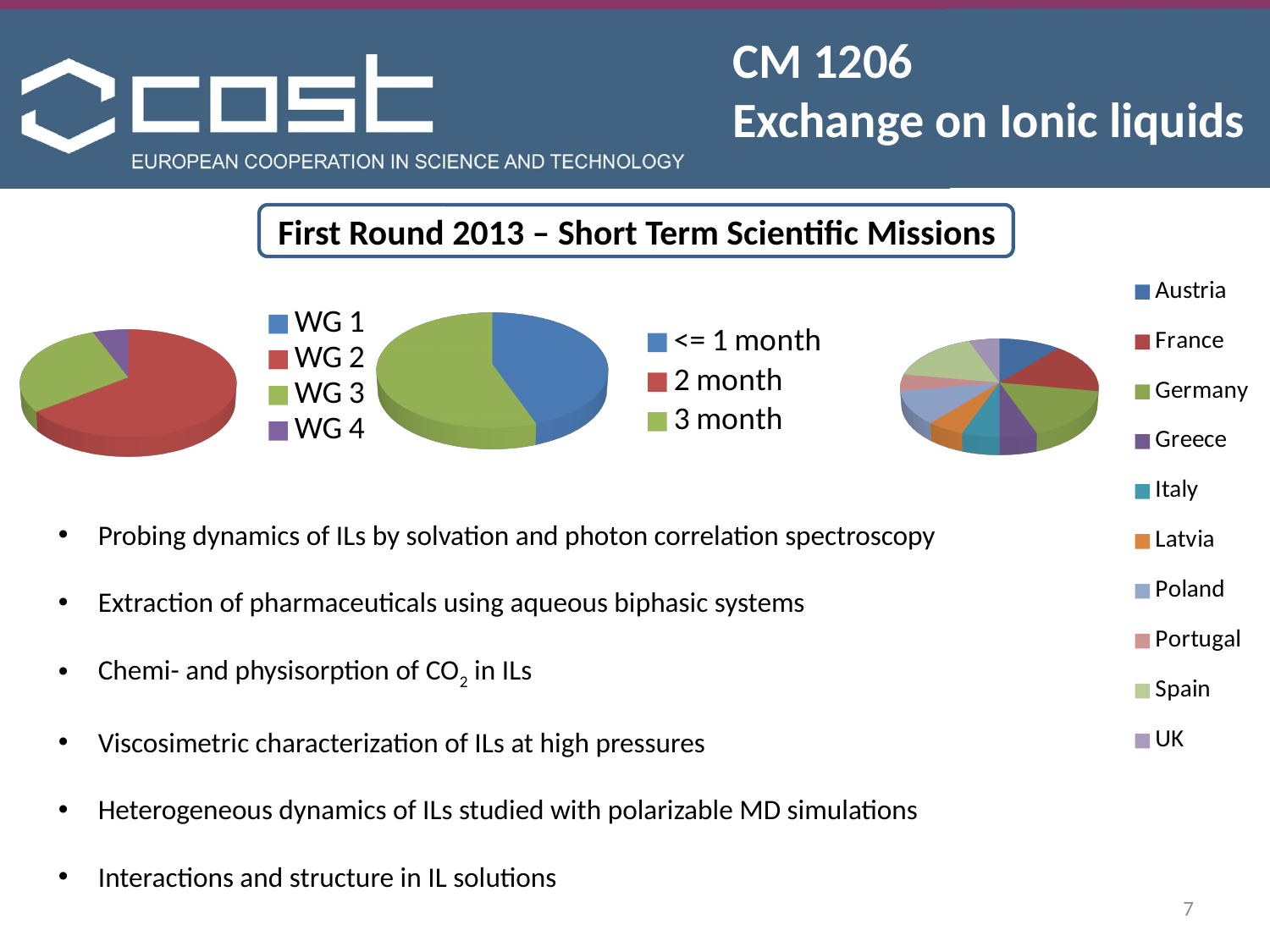
What kind of chart is the rightmost chart on the slide (the one with the country legend)? pie chart In the leftmost pie chart, how many working groups does the legend list? 4 In the middle pie chart, which category has the largest slice? 3 month In the leftmost pie chart, what colour represents WG 2? red In the middle pie chart, which slice is larger, '<= 1 month' or '3 month'? 3 month In the leftmost pie chart, which slice is larger, WG 3 or WG 4? WG 3 What kind of chart is the leftmost chart on the slide? pie chart In the leftmost pie chart, which slice is larger, WG 2 or WG 3? WG 2 In the middle pie chart, how many categories does the legend list? 3 In the rightmost pie chart, how many countries does the legend list? 10 In the leftmost pie chart, which working group has the largest slice? WG 2 In the rightmost pie chart, what colour represents Germany in the legend? green